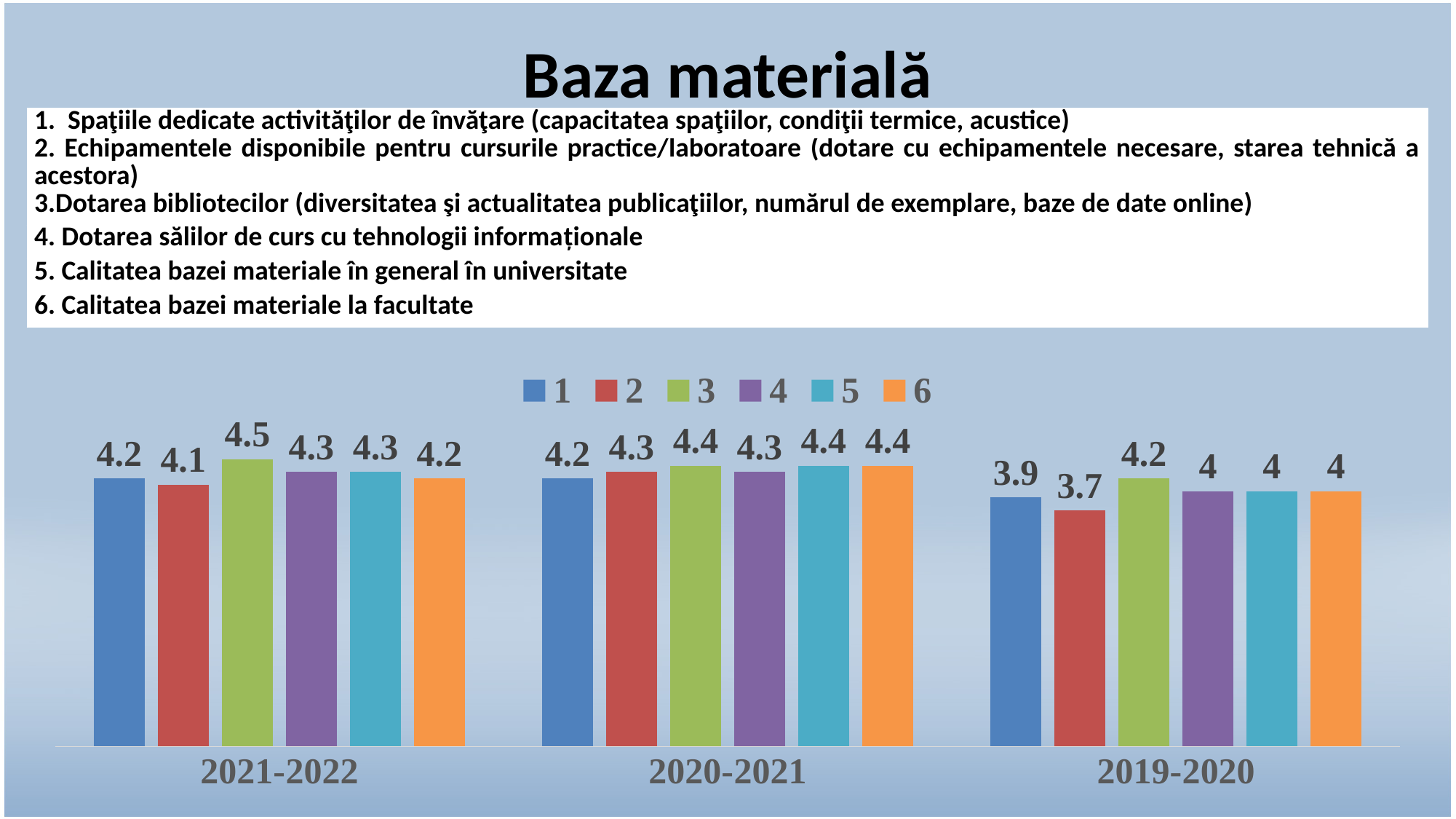
What is the value for series 2 in 2019-2020? 3.7 Which series has the highest value in 2021-2022? 3 How many categories are shown on the x axis? 3 Which series has the lowest value in 2019-2020? 2 What is the value for series 5 in 2020-2021? 4.4 Which is larger: series 1 in 2021-2022 or series 1 in 2019-2020? 2021-2022 What is the value for series 3 in 2021-2022? 4.5 What is the difference between series 3 and series 2 in 2019-2020? 0.5 What kind of chart is shown on the slide? bar chart What is the title of the slide? Baza materială What colour are the bars for series 6? orange How many series does the legend list? 6